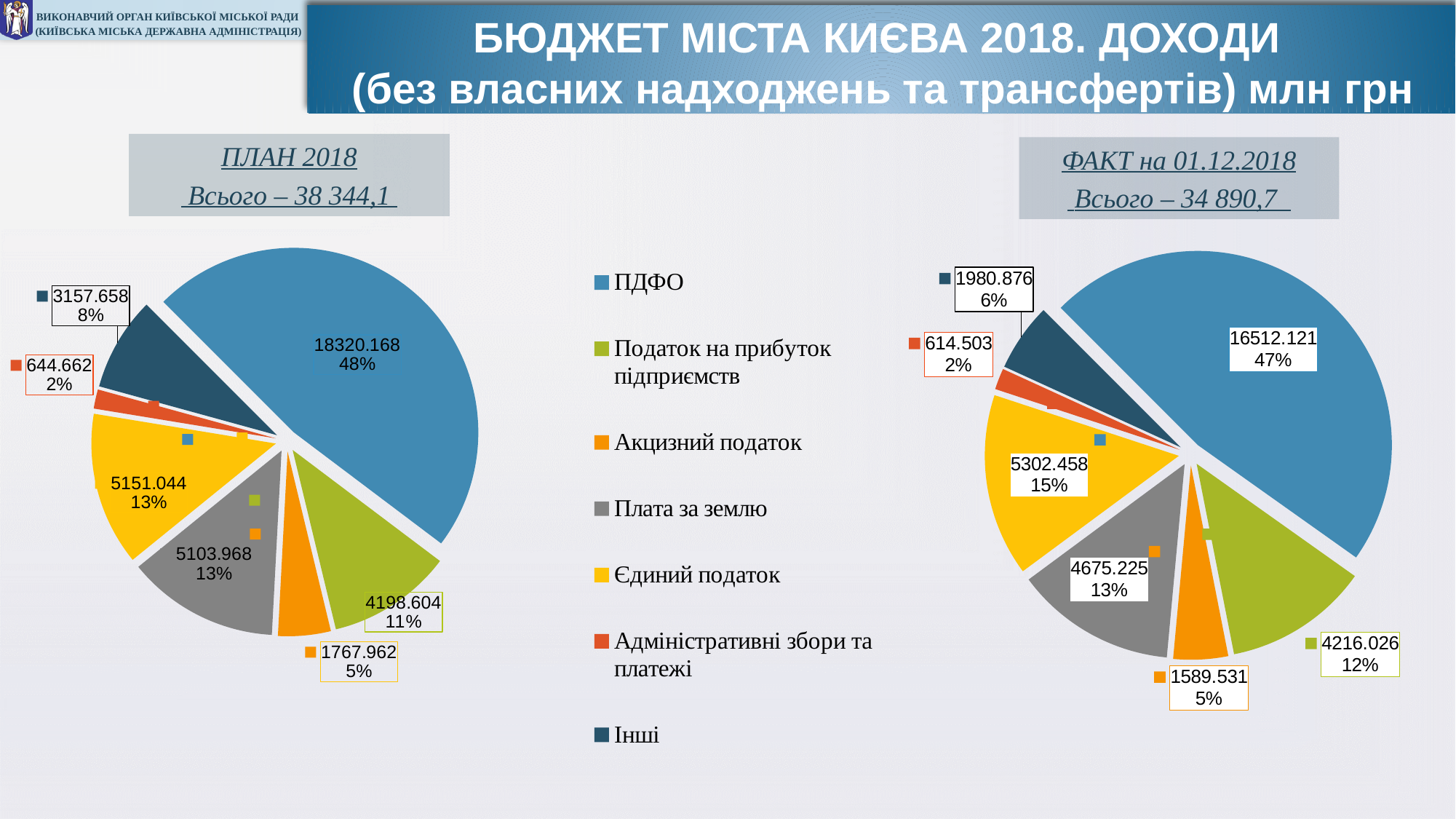
In the ПЛАН 2018 pie chart, which category has the smallest slice? Адміністративні збори та платежі In the ФАКТ на 01.12.2018 pie chart, what value is shown for Єдиний податок? 5302.458 In the ФАКТ на 01.12.2018 pie chart, which is larger: Плата за землю or Акцизний податок? Плата за землю Which colour represents Плата за землю in the legend? gray In the ПЛАН 2018 pie chart, what share of the pie does Інші take? 8% What kind of chart is used for ПЛАН 2018? pie chart In the ПЛАН 2018 pie chart, what value is shown for ПДФО? 18320.168 In the ФАКТ на 01.12.2018 pie chart, what share of the pie does ПДФО take? 47% In the ФАКТ на 01.12.2018 pie chart, which category has the largest slice? ПДФО How many series does the shared legend list? 7 In the ПЛАН 2018 pie chart, what value is shown for Акцизний податок? 1767.962 What is the difference between the ПДФО value in the ПЛАН 2018 chart and the ПДФО value in the ФАКТ на 01.12.2018 chart? 1808.047